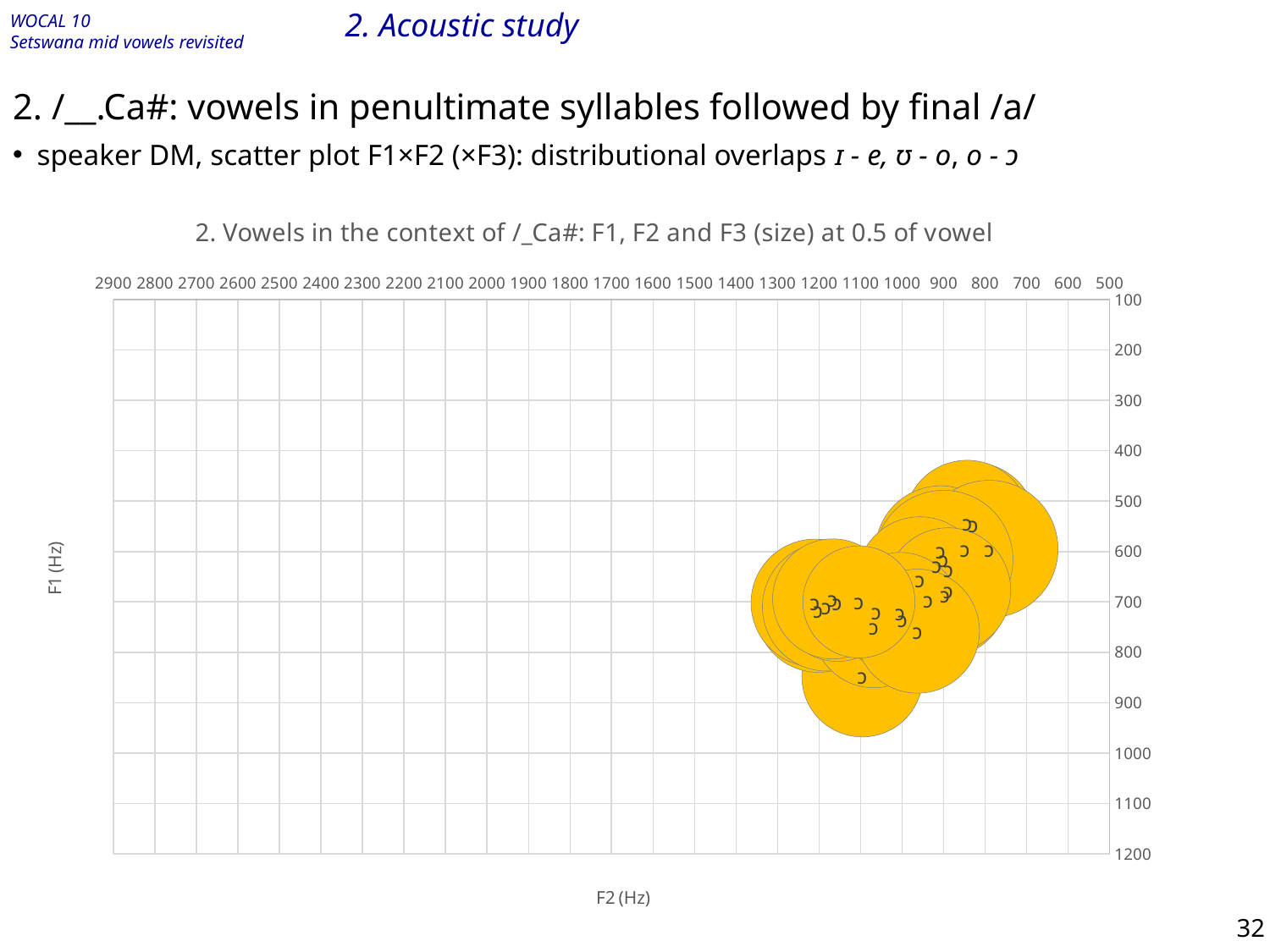
What is the title of the chart? 2. Vowels in the context of /_Ca#: F1, F2 and F3 (size) at 0.5 of vowel Is the F1 value of the lowest bubble on the chart greater or less than 700? greater What kind of chart is shown on the slide? bubble chart (scatter plot) Is the F2 value of the leftmost bubble on the chart greater or less than 1500? less What are the labels of the horizontal and vertical axes of the chart? F2 (Hz) and F1 (Hz) Is the F1 value of the topmost bubble on the chart greater or less than 300? greater